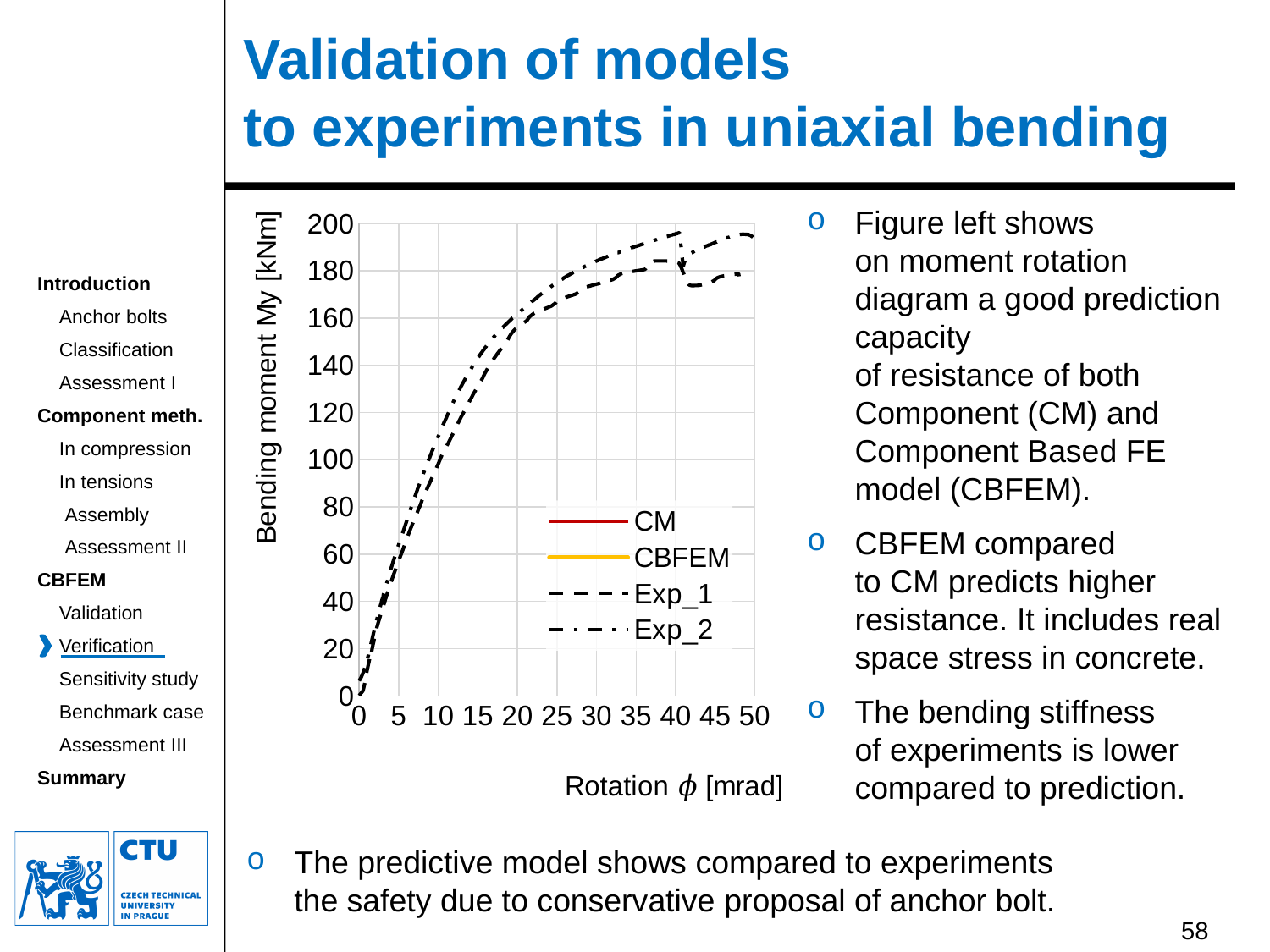
Is the Exp_2 bending moment at a rotation of 15 mrad greater or less than 120 kNm? greater What is the label of the vertical axis of the chart? Bending moment My [kNm] How many series does the chart legend list? 4 Is the Exp_1 bending moment at a rotation of 15 mrad greater or less than 100 kNm? greater What kind of chart is shown on the slide? line chart At a rotation of 20 mrad, which series shows the higher bending moment, Exp_1 or Exp_2? Exp_2 Does the Exp_2 bending moment rise or fall as rotation increases from 0 to 20 mrad? rise What is the highest value shown on the vertical axis of the chart? 200 What is the label of the horizontal axis of the chart? Rotation ϕ [mrad] Is the Exp_1 bending moment at a rotation of 30 mrad greater or less than 160 kNm? greater